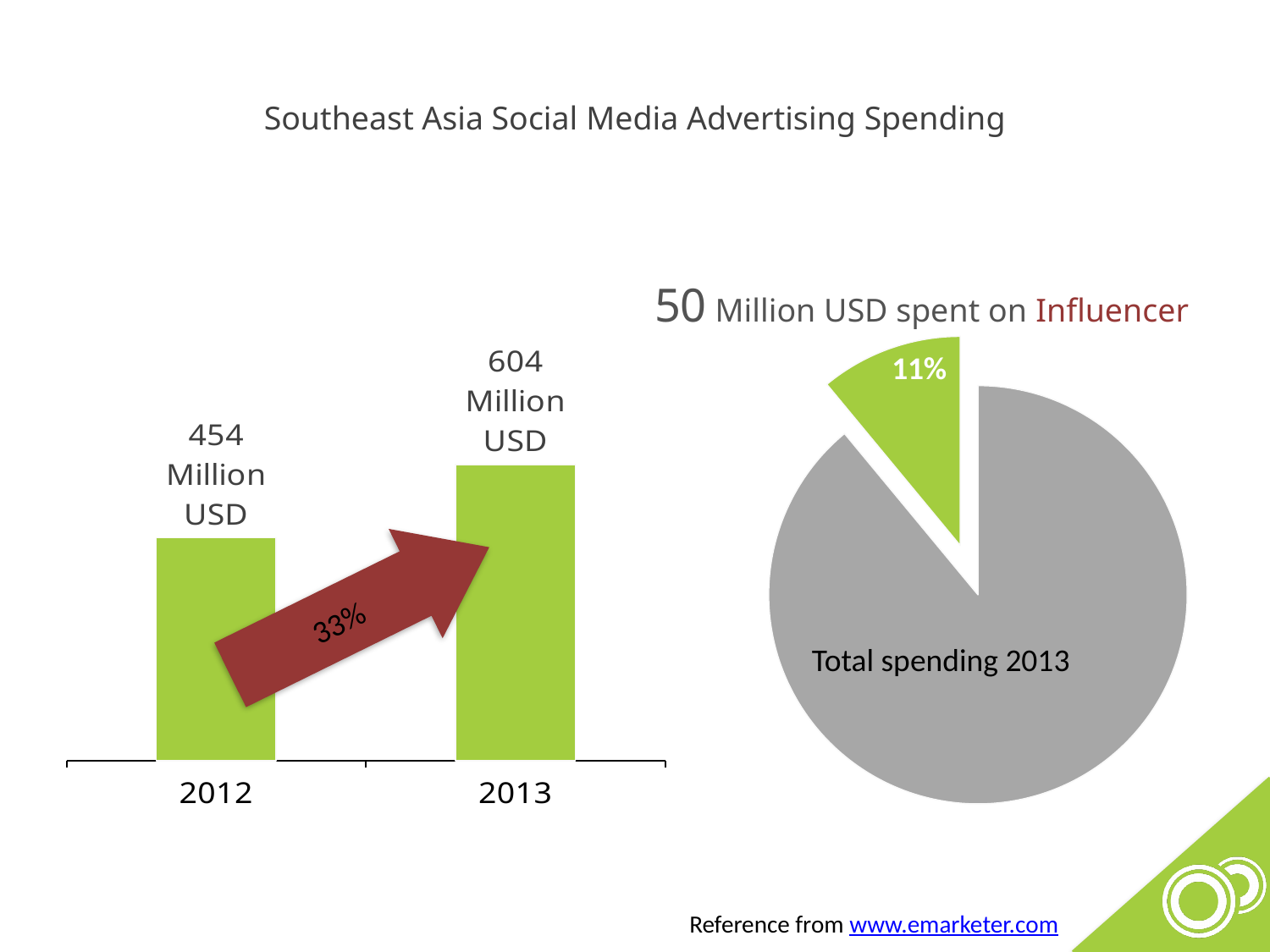
In the bar chart on the left, what is the value for 2012? 454 Million USD In the bar chart on the left, what is the value for 2013? 604 Million USD In the bar chart on the left, which year has the lower spending? 2012 In the bar chart on the left, how many years are shown? 2 What kind of chart is on the left side of the slide? bar chart In the bar chart on the left, what is the difference between the 2013 and 2012 values? 150 Million USD What percentage growth is written on the arrow in the bar chart on the left? 33% In the bar chart on the left, which year has the higher spending? 2013 In the bar chart on the left, is the value for 2013 larger or smaller than the value for 2012? larger What kind of chart is on the right side of the slide? pie chart In the bar chart on the left, do the values rise or fall from 2012 to 2013? rise In the pie chart on the right, what share of total spending 2013 is the green slice? 11%